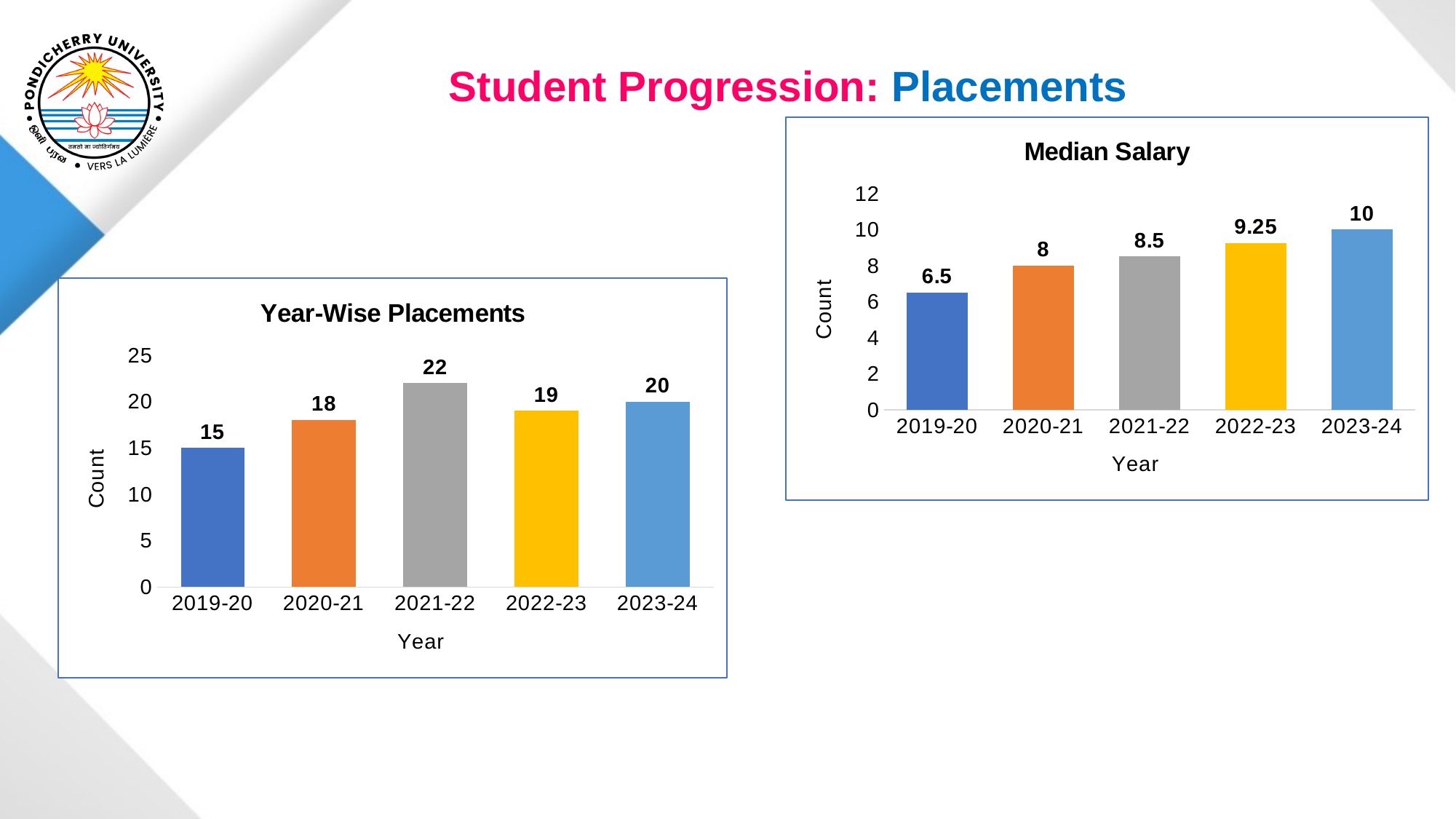
In the Median Salary chart, which year has the highest value? 2023-24 In the Median Salary chart, do the values rise or fall from 2019-20 to 2023-24? rise In the Year-Wise Placements chart, which year has the highest value? 2021-22 In the Median Salary chart, what is the difference between the values for 2023-24 and 2019-20? 3.5 How many years are shown in the Year-Wise Placements chart? 5 What is the label on the vertical axis of the Median Salary chart? Count In the Median Salary chart, what is the value for 2022-23? 9.25 In the Year-Wise Placements chart, what is the difference between the values for 2021-22 and 2019-20? 7 In the Year-Wise Placements chart, what is the value for 2021-22? 22 In the Year-Wise Placements chart, which year has the lowest value? 2019-20 In the Year-Wise Placements chart, which is larger, the value for 2022-23 or 2023-24? 2023-24 What kind of chart is the Year-Wise Placements chart? bar chart